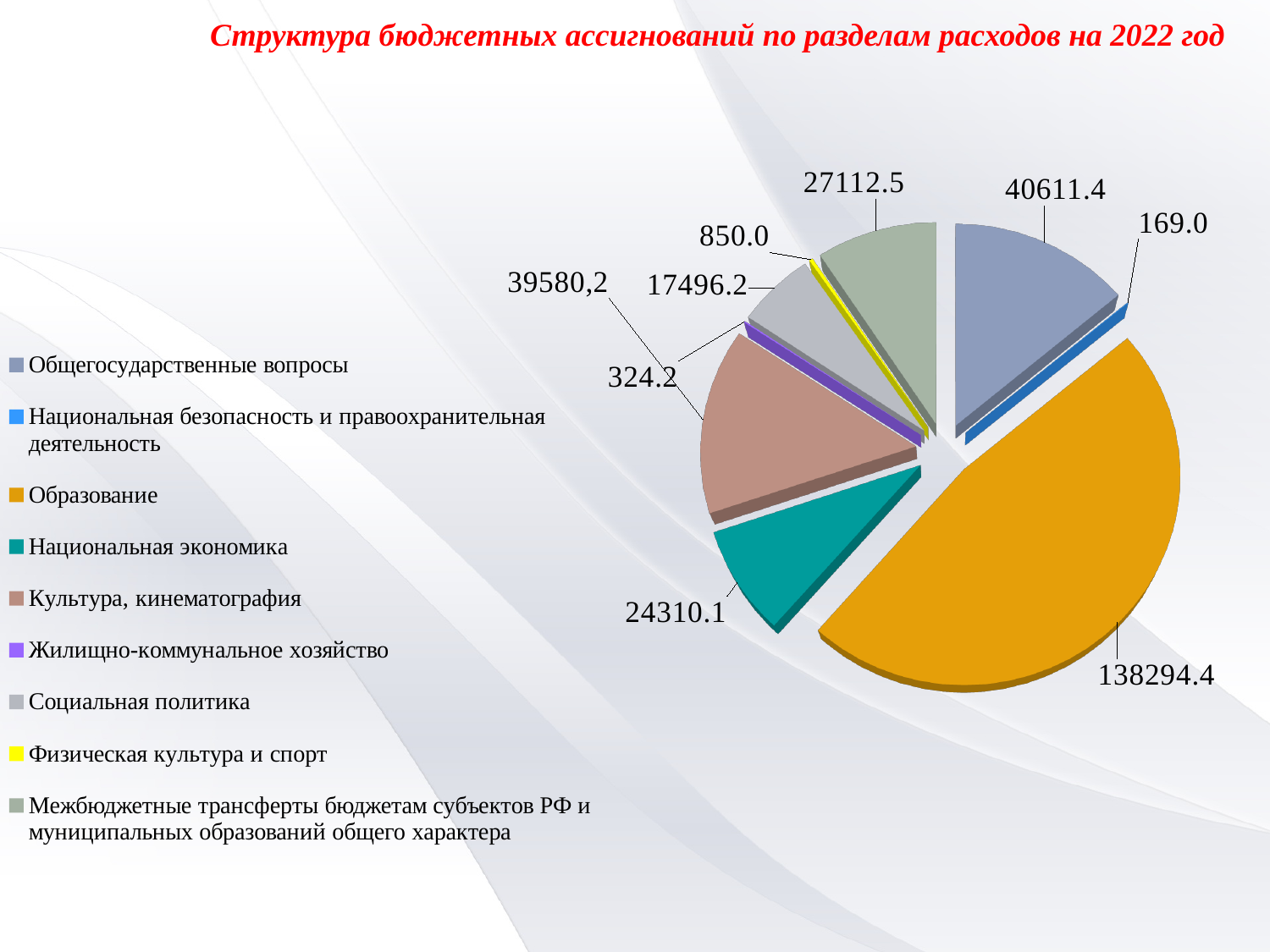
What is the value for Национальная экономика? 24310.1 What is the value for Общегосударственные вопросы? 40611.4 Which category has the smallest slice of the pie? Национальная безопасность и правоохранительная деятельность What is the value for Образование? 138294.4 What type of chart is shown on the slide? pie chart What is the value for Социальная политика? 17496.2 Which category has the largest slice of the pie? Образование Which is larger: the value for Межбюджетные трансферты бюджетам субъектов РФ и муниципальных образований общего характера or the value for Национальная экономика? Межбюджетные трансферты бюджетам субъектов РФ и муниципальных образований общего характера What is the title of the chart? Структура бюджетных ассигнований по разделам расходов на 2022 год What is the value for Физическая культура и спорт? 850.0 What is the difference between the values for Общегосударственные вопросы and Культура, кинематография? 1031.2 How many categories does the legend list? 9